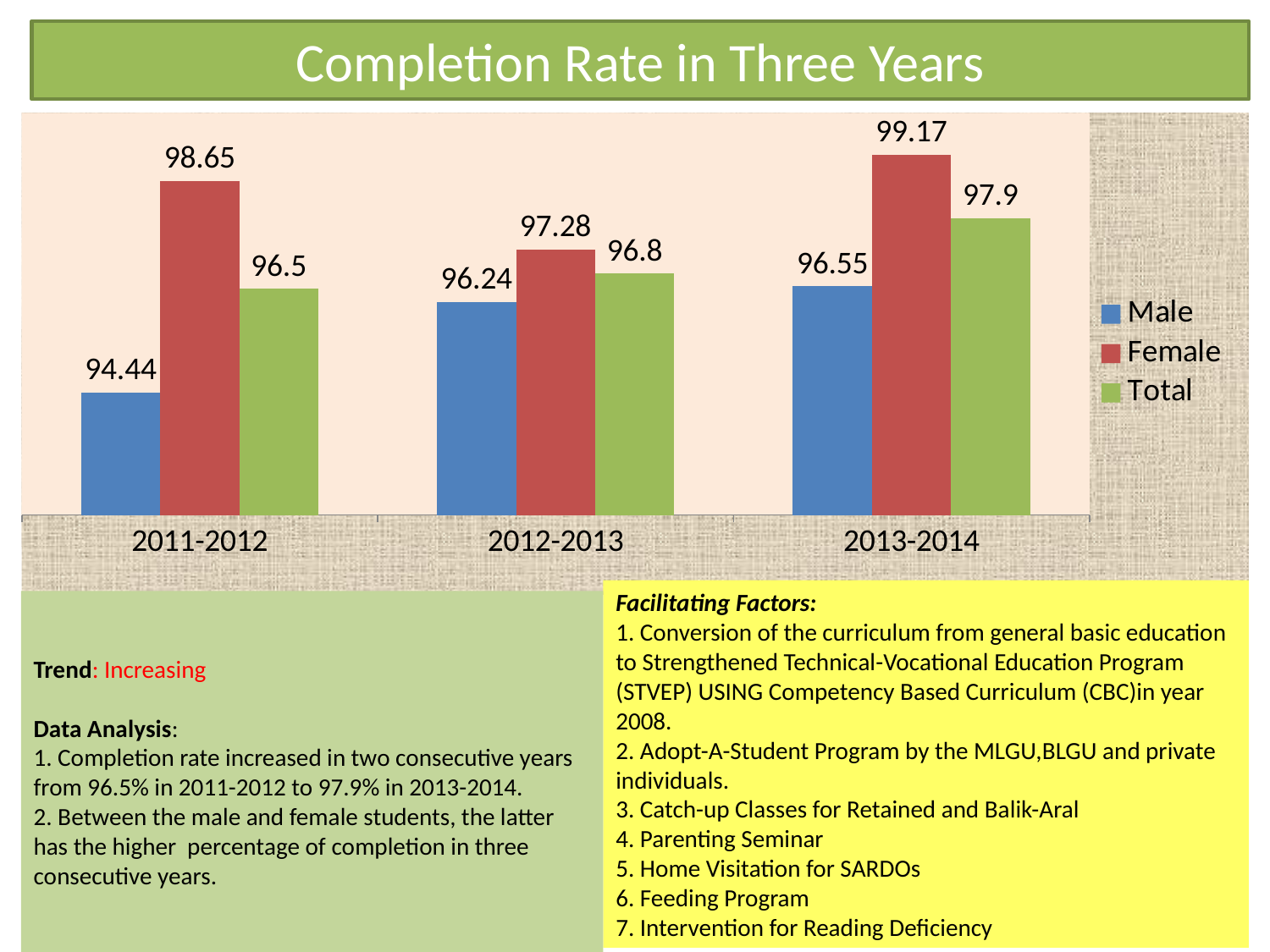
What colour represents the Female series in the chart? Red In which year is the Male completion rate lowest? 2011-2012 Does the Total completion rate rise or fall from 2011-2012 to 2013-2014? Rise What is the Male completion rate for 2011-2012? 94.44 How many series does the legend list? 3 Which is larger in 2012-2013, the Female rate or the Total rate? Female What is the Total completion rate for 2012-2013? 96.8 How many year categories are shown on the x axis? 3 What is the difference between the Female and Male completion rates in 2011-2012? 4.21 In which year is the Female completion rate highest? 2013-2014 What kind of chart is shown on the slide? Bar chart What is the Female completion rate for 2013-2014? 99.17